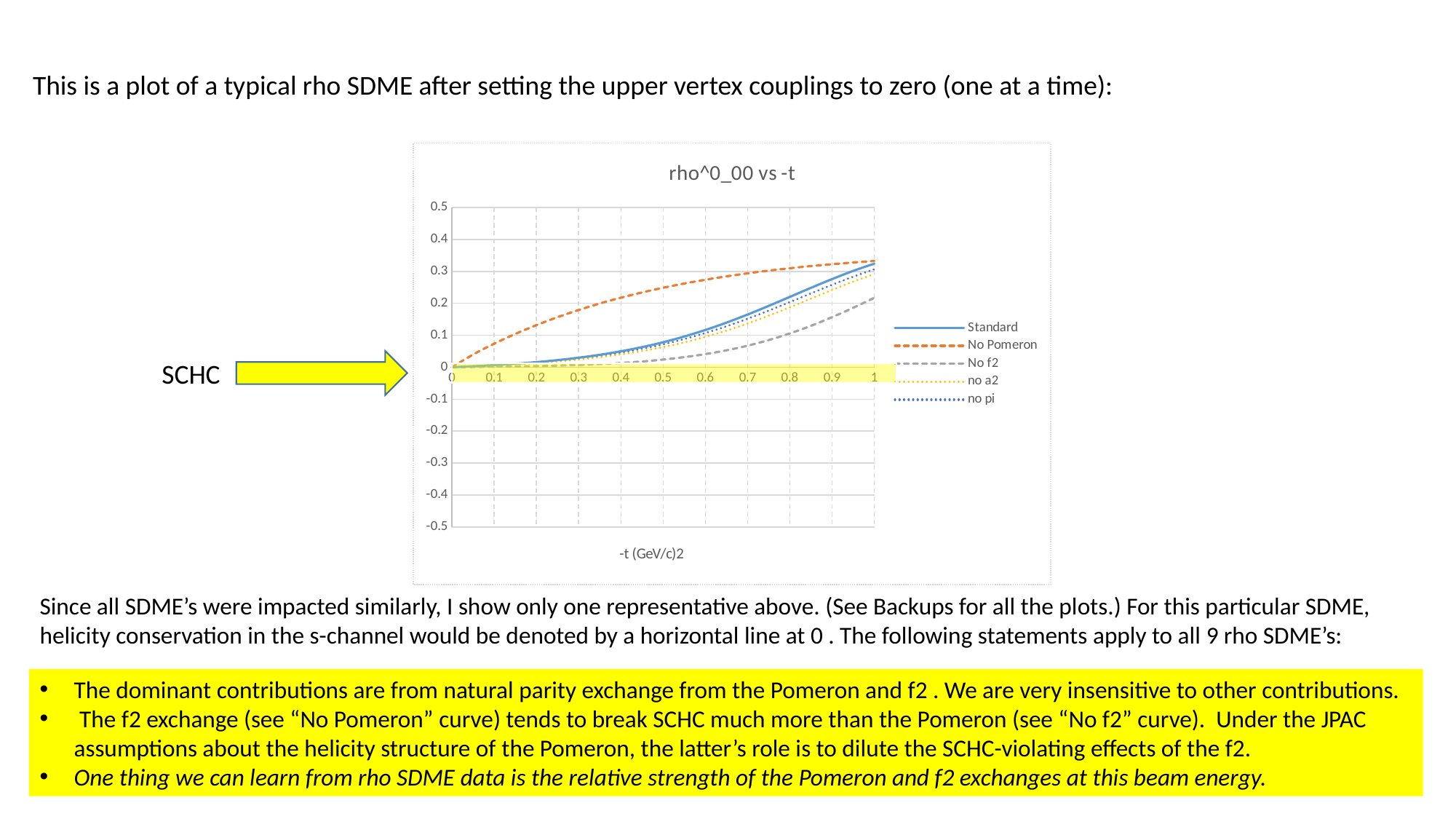
Which series has the highest value at -t = 0.5? No Pomeron Which series has the lowest value at -t = 1? No f2 Is the value of the No f2 series at -t = 0.5 greater or less than 0.1? less What is the label of the x axis of the chart? -t (GeV/c)2 How many series does the legend of the chart list? 5 Does the No Pomeron series rise or fall as -t increases from 0 to 1? rise What is the title of the chart? rho^0_00 vs -t Which series has the lowest value at -t = 0.5? No f2 What kind of chart is shown on the slide? line chart Is the value of the No f2 series at -t = 1 greater or less than 0.3? less Is the value of the No Pomeron series at -t = 0.5 greater or less than 0.2? greater At -t = 0.5, which series has the larger value, No Pomeron or Standard? No Pomeron